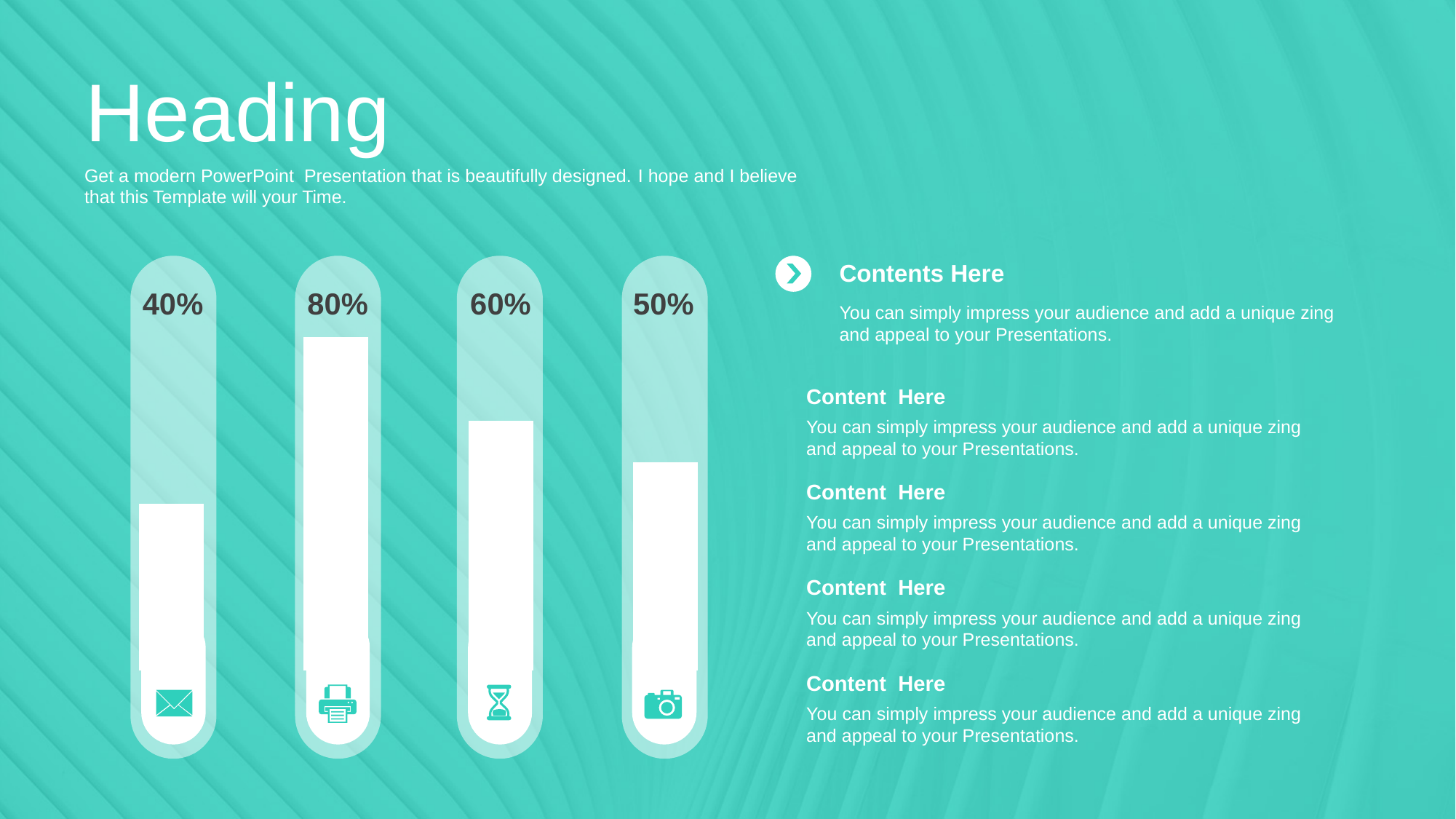
What value is shown on the rightmost bar, the one with the camera icon? 50% How many bars are shown in the chart? 4 What value is shown on the first (leftmost) bar, the one with the envelope icon? 40% What is the difference between the hourglass bar and the camera bar? 10% Which bar has the highest value? The second bar (printer icon), 80% What kind of chart is shown on the slide? Bar chart Which is larger, the value of the envelope bar or the value of the camera bar? The camera bar (50%) What is the difference between the highest and lowest bar values? 40% What icon appears at the bottom of the bar labelled 60%? An hourglass What value is shown on the bar with the printer icon? 80% What value is shown on the third bar, the one with the hourglass icon? 60% Which bar has the lowest value? The first bar (envelope icon), 40%